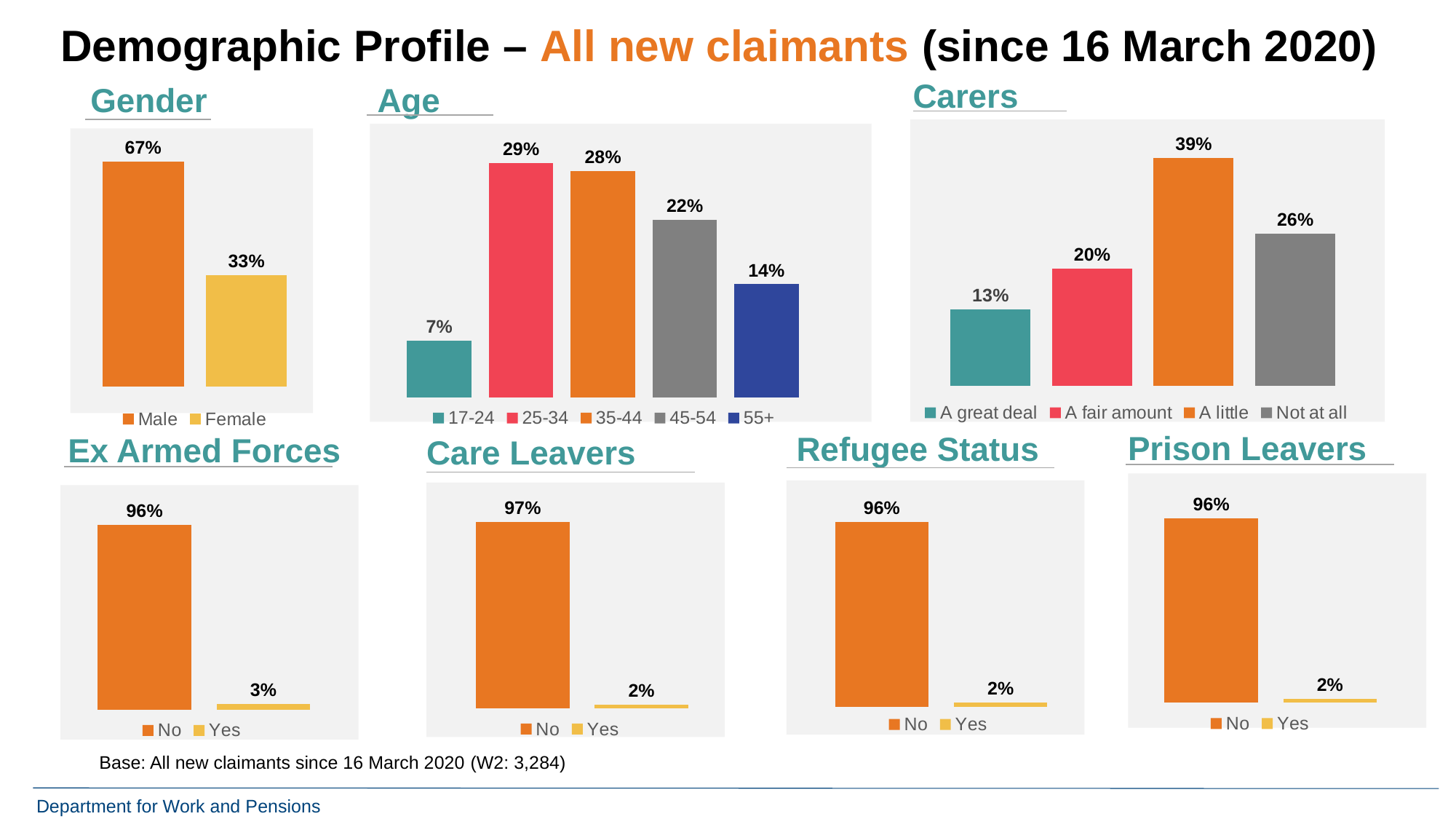
In the Carers chart, which category has the highest value? A little In the Age chart, which age group has the lowest percentage? 17-24 In the Carers chart, what is the value for 'A fair amount'? 20% In the Care Leavers chart, what percentage answered Yes? 2% In the Age chart, what is the difference between the 45-54 and 55+ percentages? 8% How many categories does the Age chart show? 5 In the Gender chart, what is the difference between the Male and Female percentages? 34% In the Gender chart, what percentage of new claimants are Male? 67% How many entries does the legend of the Carers chart list? 4 What kind of chart is the Ex Armed Forces chart? Bar chart In the Age chart, which age group has the highest percentage? 25-34 In the Carers chart, which is larger: 'A great deal' or 'Not at all'? Not at all